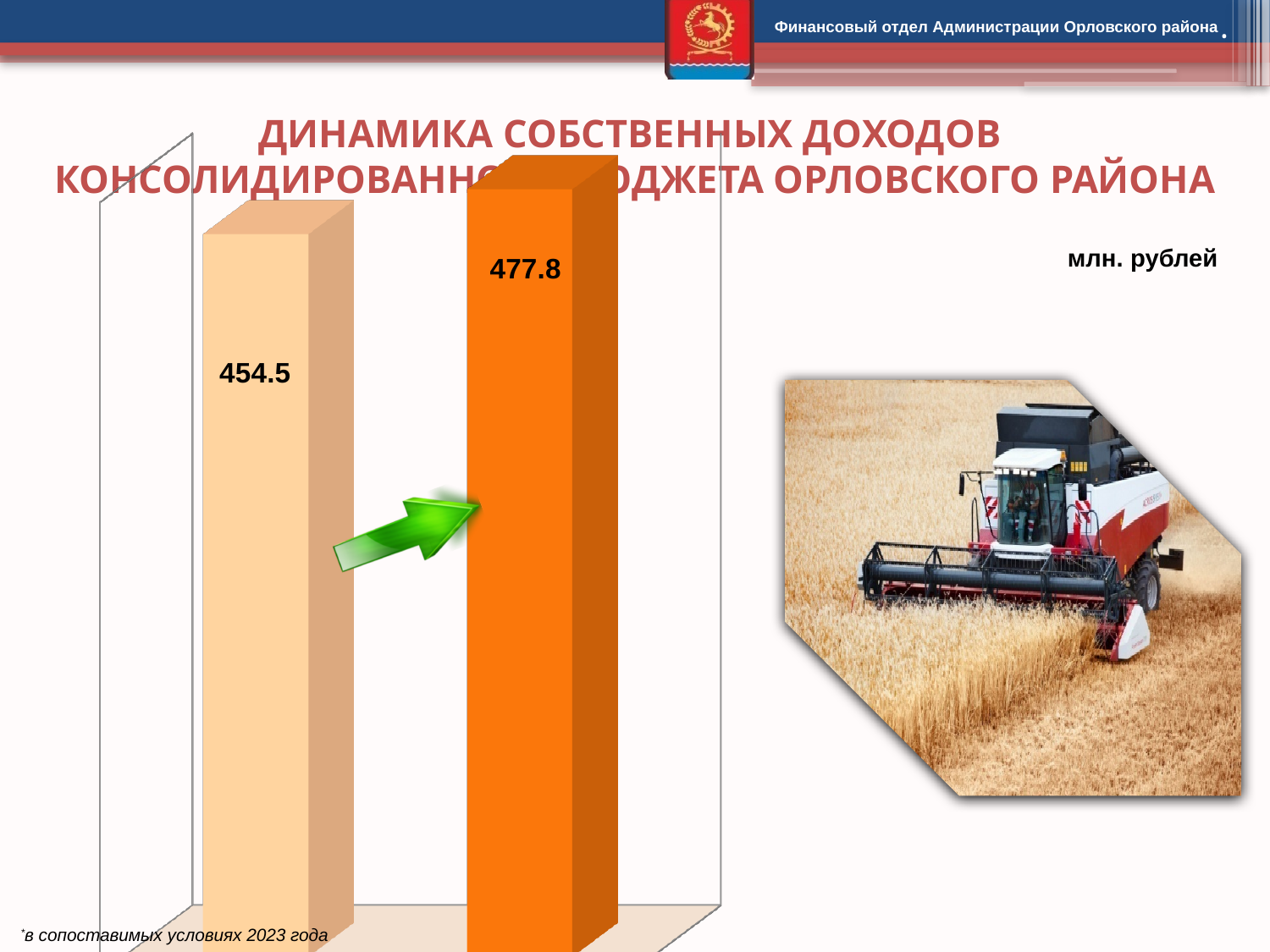
What type of chart is shown on the slide? bar chart What value is printed on the left (light orange) bar of the chart? 454.5 Do the values rise or fall from the left bar to the right bar? rise Which bar has the lower value, the left one or the right one? the left one How many bars are plotted in the chart? 2 Which bar has the higher value, the left one or the right one? the right one What is the difference between the values of the right bar and the left bar? 23.3 Is the value of the right bar larger or smaller than the value of the left bar? larger What value is printed on the right (dark orange) bar of the chart? 477.8 What colour is the bar with the value 477.8? orange In what units are the chart values given, according to the label on the slide? млн. рублей